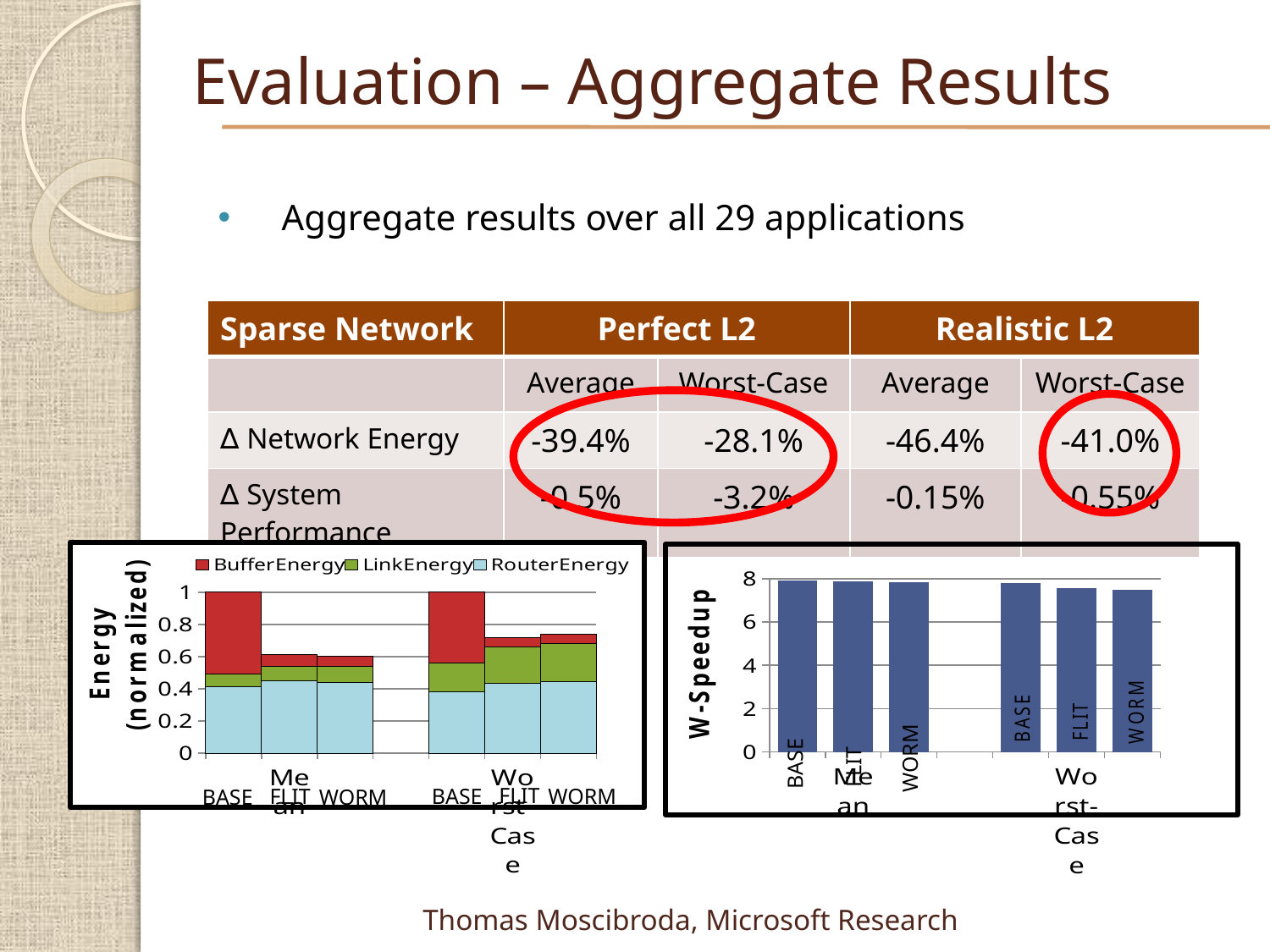
What kind of chart is the right chart (W-Speedup)? bar chart In the right chart (W-Speedup), how many bars are plotted in total? 6 In the left chart (Energy normalized), how many series does the legend list? 3 In the left chart (Energy normalized), what are the three series named in the legend? BufferEnergy, LinkEnergy, RouterEnergy In the left chart (Energy normalized), which colour represents BufferEnergy? red What kind of chart is the left chart (Energy normalized)? stacked bar chart In the left chart (Energy normalized), is the total for WORM in the Worst-Case group greater or less than 0.8? less In the left chart (Energy normalized), is the total for FLIT in the Mean group greater or less than 0.8? less In the left chart (Energy normalized), how many bars are plotted in total? 6 In the left chart (Energy normalized), which has the larger total energy in the Mean group, BASE or FLIT? BASE In the right chart (W-Speedup), is the value for BASE in the Mean group greater or less than 6? greater In the left chart (Energy normalized), what is the total normalized energy of the BASE bar in the Mean group? 1